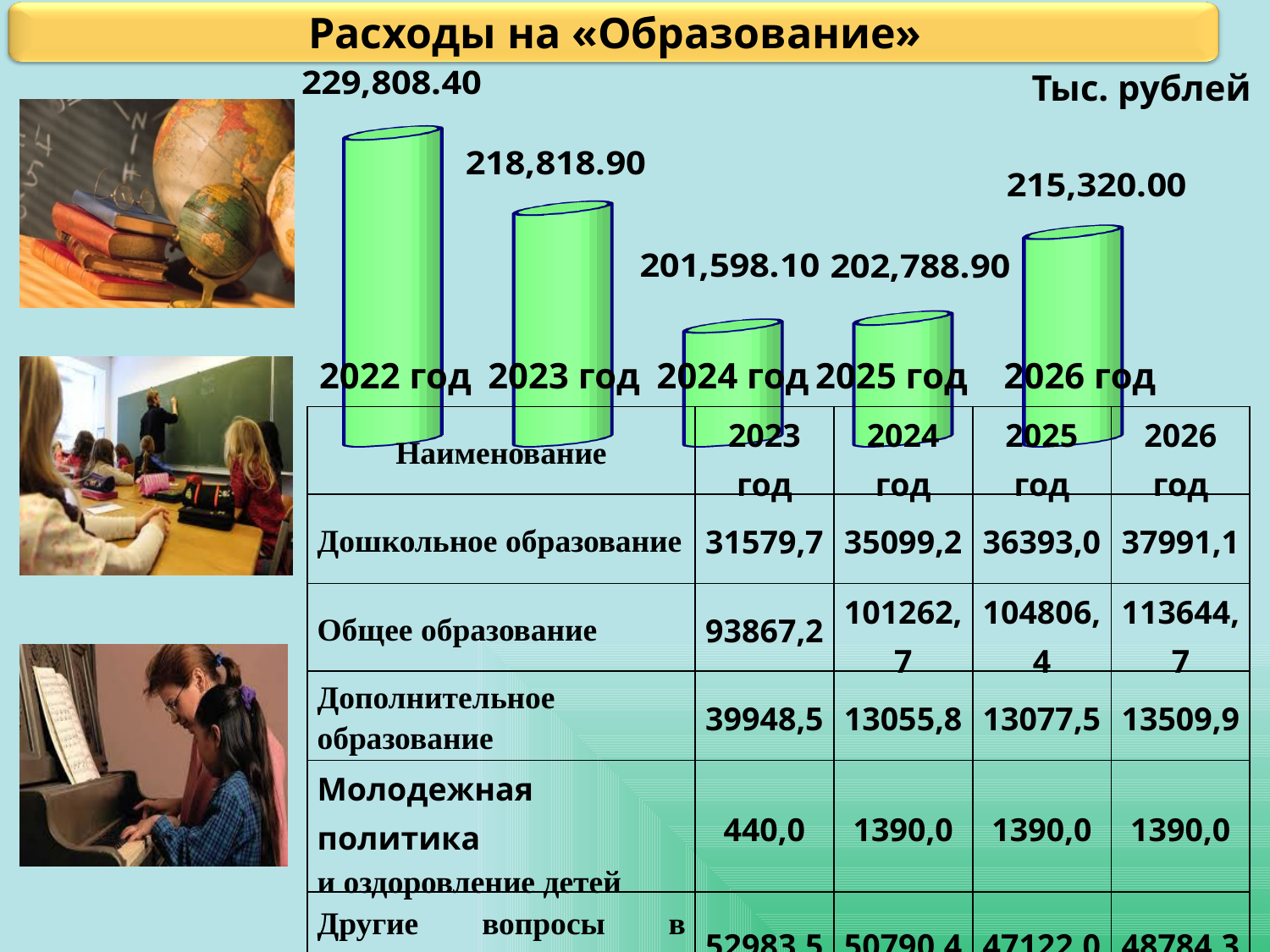
What kind of chart is shown on the slide? bar chart How many years are shown on the chart? 5 Which is larger, the value for 2023 год or the value for 2026 год? 2023 год What is the difference between the values for 2022 год and 2023 год? 10,989.50 Which year has the lowest value on the chart? 2024 год What is the difference between the values for 2026 год and 2025 год? 12,531.10 What is the value for 2022 год on the chart? 229,808.40 What is the value for 2026 год on the chart? 215,320.00 What is the value for 2025 год on the chart? 202,788.90 Do the values fall or rise from 2022 год to 2024 год? fall What is the value for 2024 год on the chart? 201,598.10 Which year has the highest value on the chart? 2022 год